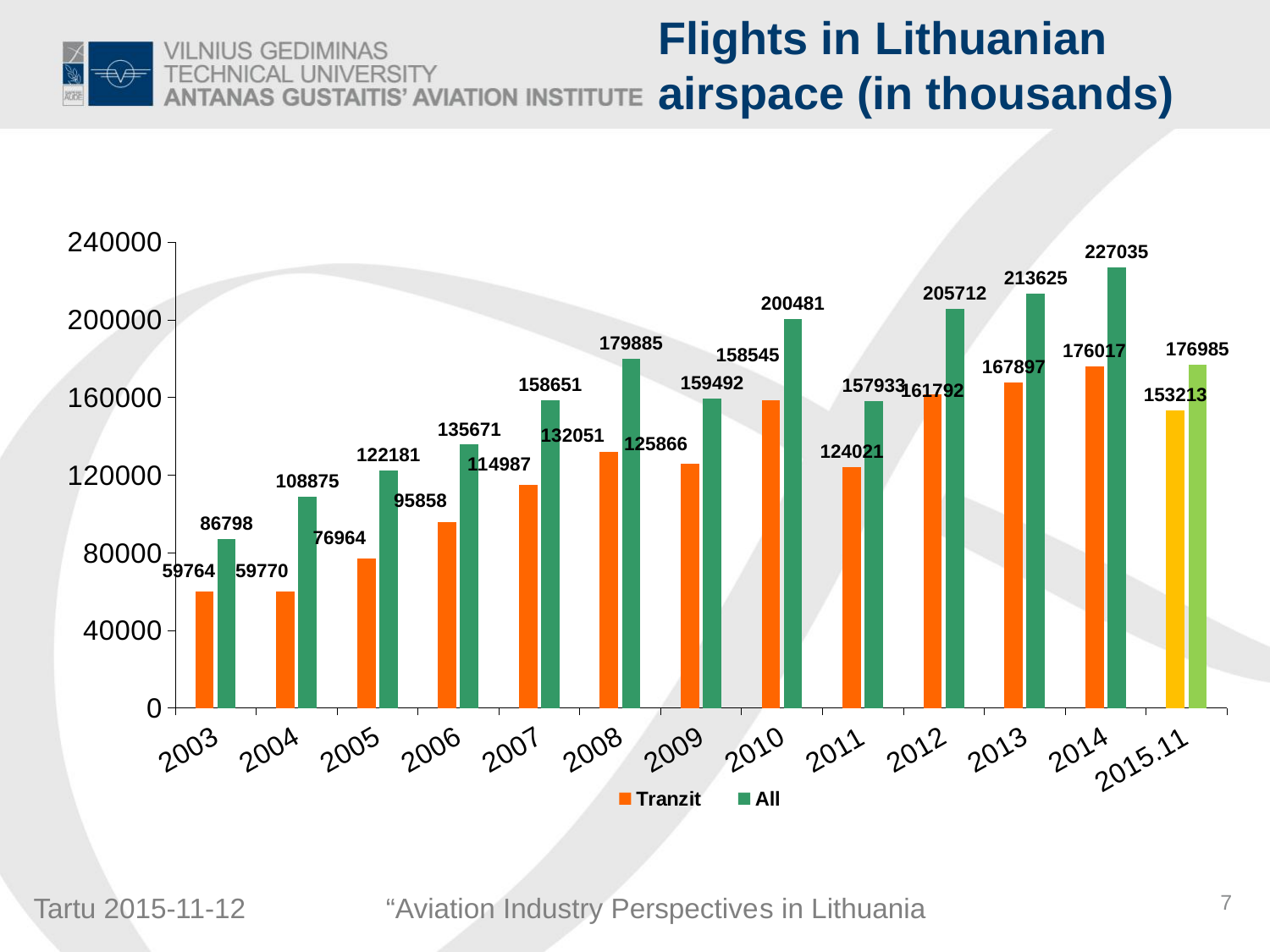
What is the Tranzit value for 2014? 176017 What is the value of the All series for 2010? 200481 In which year is the All series highest? 2014 How many series does the legend list? 2 Which year has the larger Tranzit value, 2008 or 2009? 2008 How many categories are shown on the x axis? 13 What is the difference between the All value and the Tranzit value in 2014? 51018 By how much did the All value increase from 2012 to 2013? 7913 In which year is the All series lowest? 2003 What kind of chart is shown on the slide? Bar chart Does the All series rise or fall from 2003 to 2008? Rise What is the All value for 2015.11? 176985